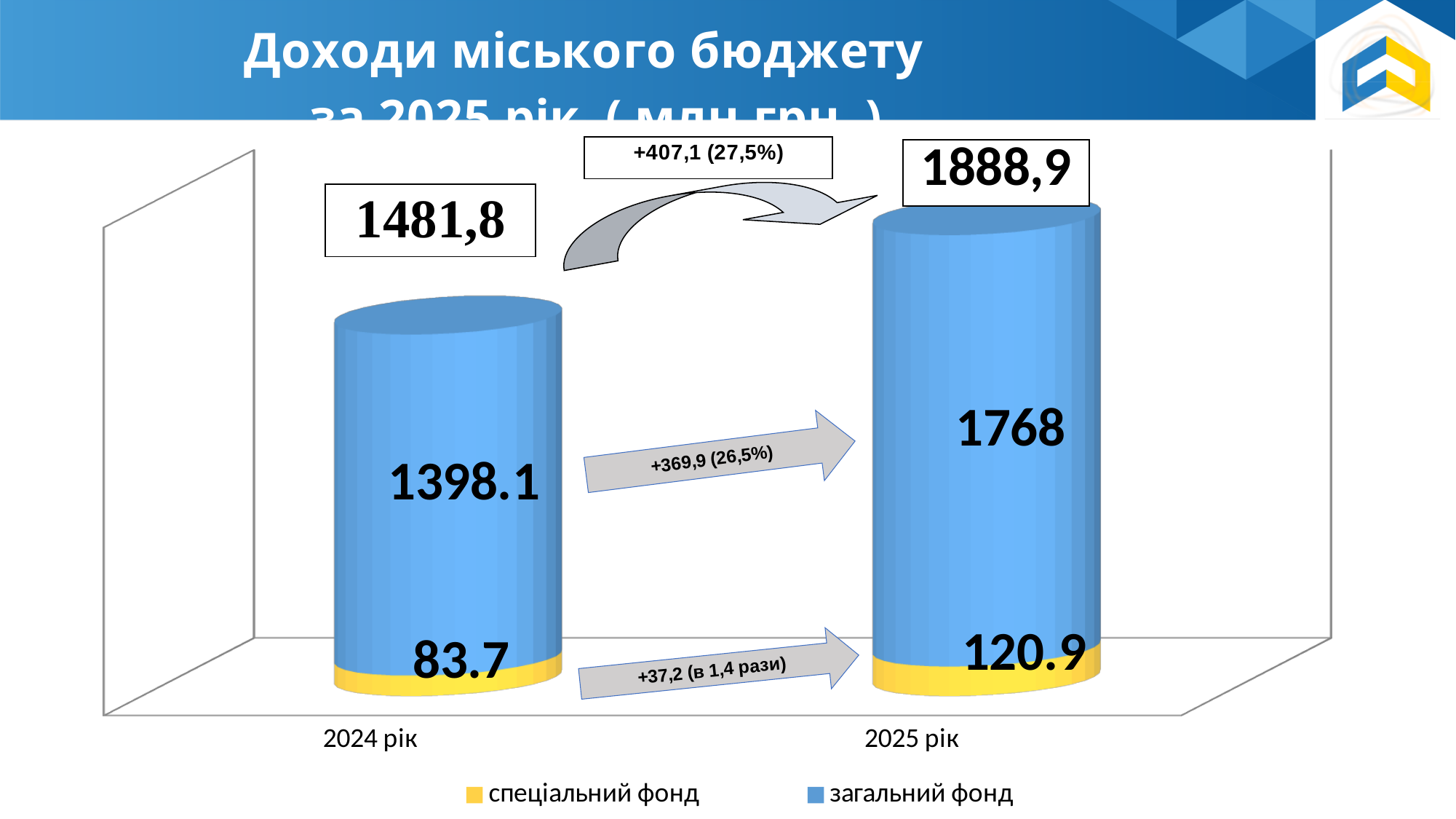
How many series does the legend list? 2 What is the value of загальний фонд for 2025 рік? 1768 Which series is shown in yellow? спеціальний фонд What is the value of спеціальний фонд for 2024 рік? 83.7 How many categories are shown on the x axis? 2 Which year has the higher value for загальний фонд? 2025 рік What is the total shown above the bar for 2025 рік? 1888,9 What is the total shown above the bar for 2024 рік? 1481,8 What is the value of загальний фонд for 2024 рік? 1398.1 What is the value of спеціальний фонд for 2025 рік? 120.9 What is the difference between the загальний фонд values for 2025 рік and 2024 рік? 369.9 What is the difference between the спеціальний фонд values for 2025 рік and 2024 рік? 37.2